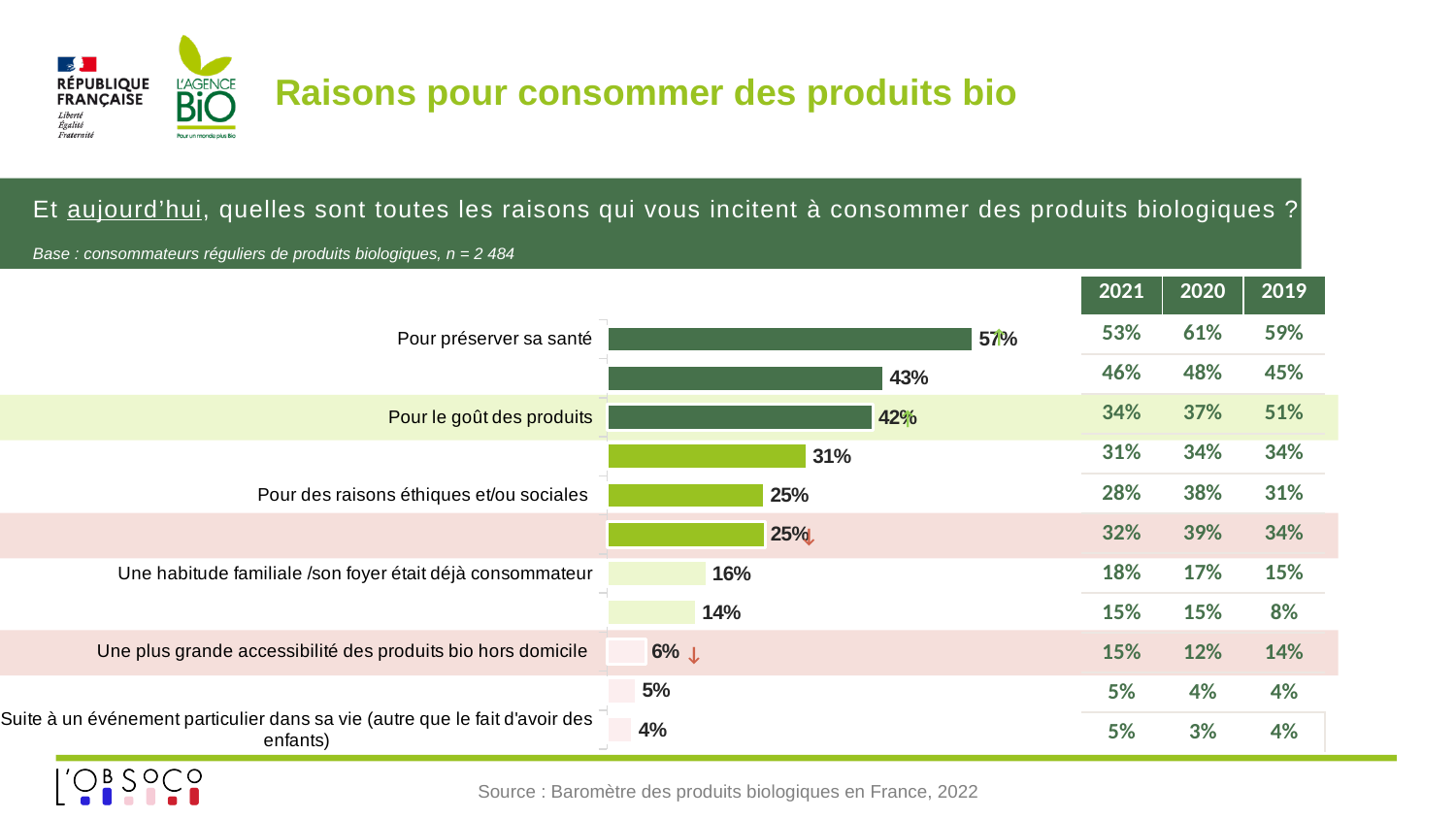
What kind of chart is shown on the slide? bar chart Which category has the lowest value? Suite à un événement particulier dans sa vie (autre que le fait d'avoir des enfants) What is the value for "Pour des raisons éthiques et/ou sociales"? 25% What is the difference between the values for "Pour préserver sa santé" and "Pour le goût des produits"? 15 percentage points Which category has the highest value? Pour préserver sa santé What is the value for "Suite à un événement particulier dans sa vie (autre que le fait d'avoir des enfants)"? 4% What is the value for "Une habitude familiale /son foyer était déjà consommateur"? 16% How many bars are plotted in the chart? 11 What is the value for "Une plus grande accessibilité des produits bio hors domicile"? 6% Which is larger, the value for "Pour le goût des produits" or for "Pour des raisons éthiques et/ou sociales"? Pour le goût des produits What is the value for "Pour préserver sa santé"? 57% What is the value for "Pour le goût des produits"? 42%